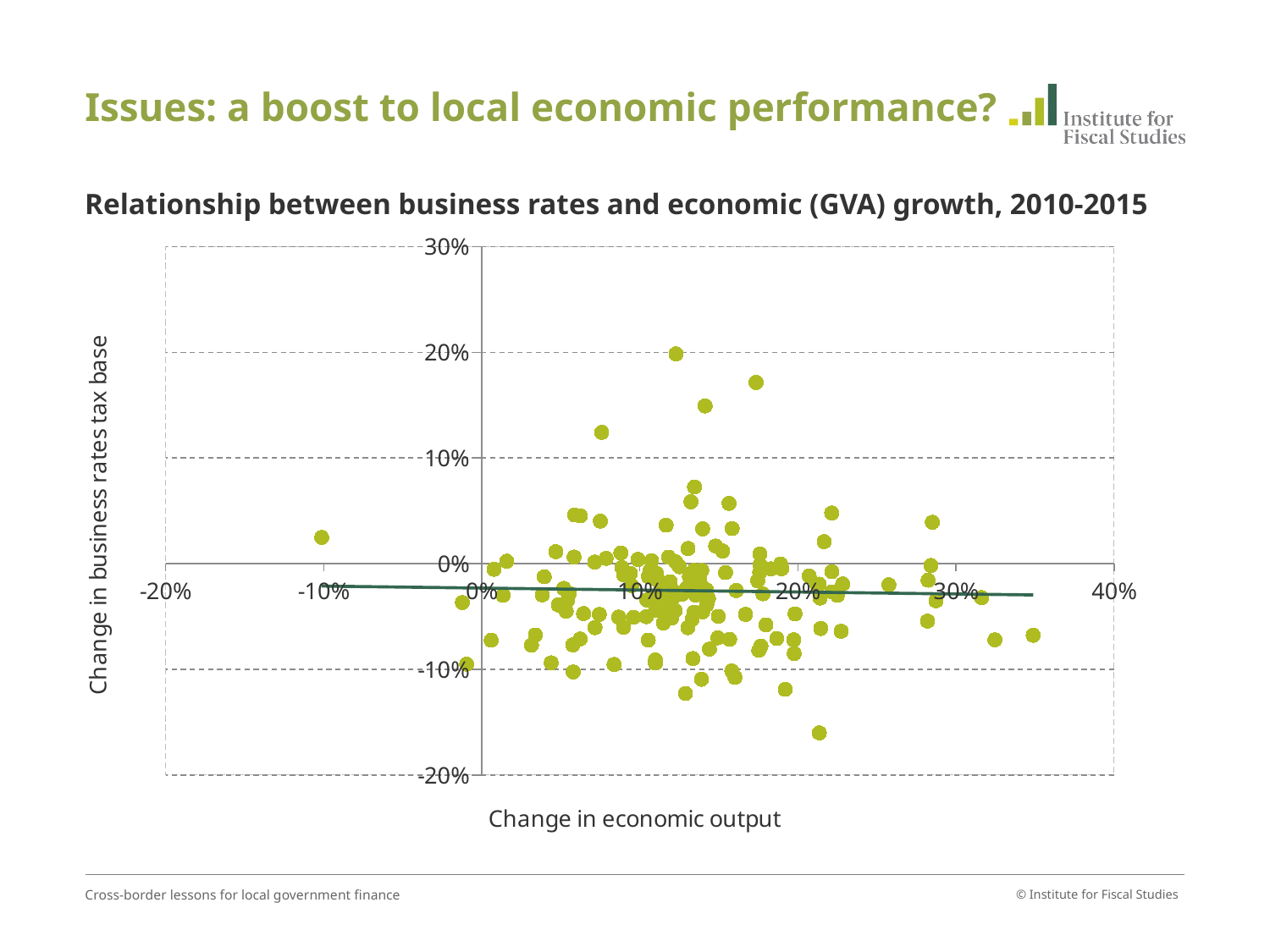
What is the highest value shown on the horizontal axis? 40% Does the fitted trend line rise or fall as change in economic output increases? fall Is the change in business rates tax base for the lowest plotted point greater or less than -10%? less What is the lowest value shown on the vertical axis? -20% What is the title of the chart? Relationship between business rates and economic (GVA) growth, 2010-2015 Is the change in business rates tax base for the highest plotted point greater or less than 10%? greater What is the label of the horizontal axis? Change in economic output What kind of chart is shown on the slide? scatter chart Is the change in economic output for the leftmost plotted point greater or less than 0%? less What is the highest value shown on the vertical axis? 30%